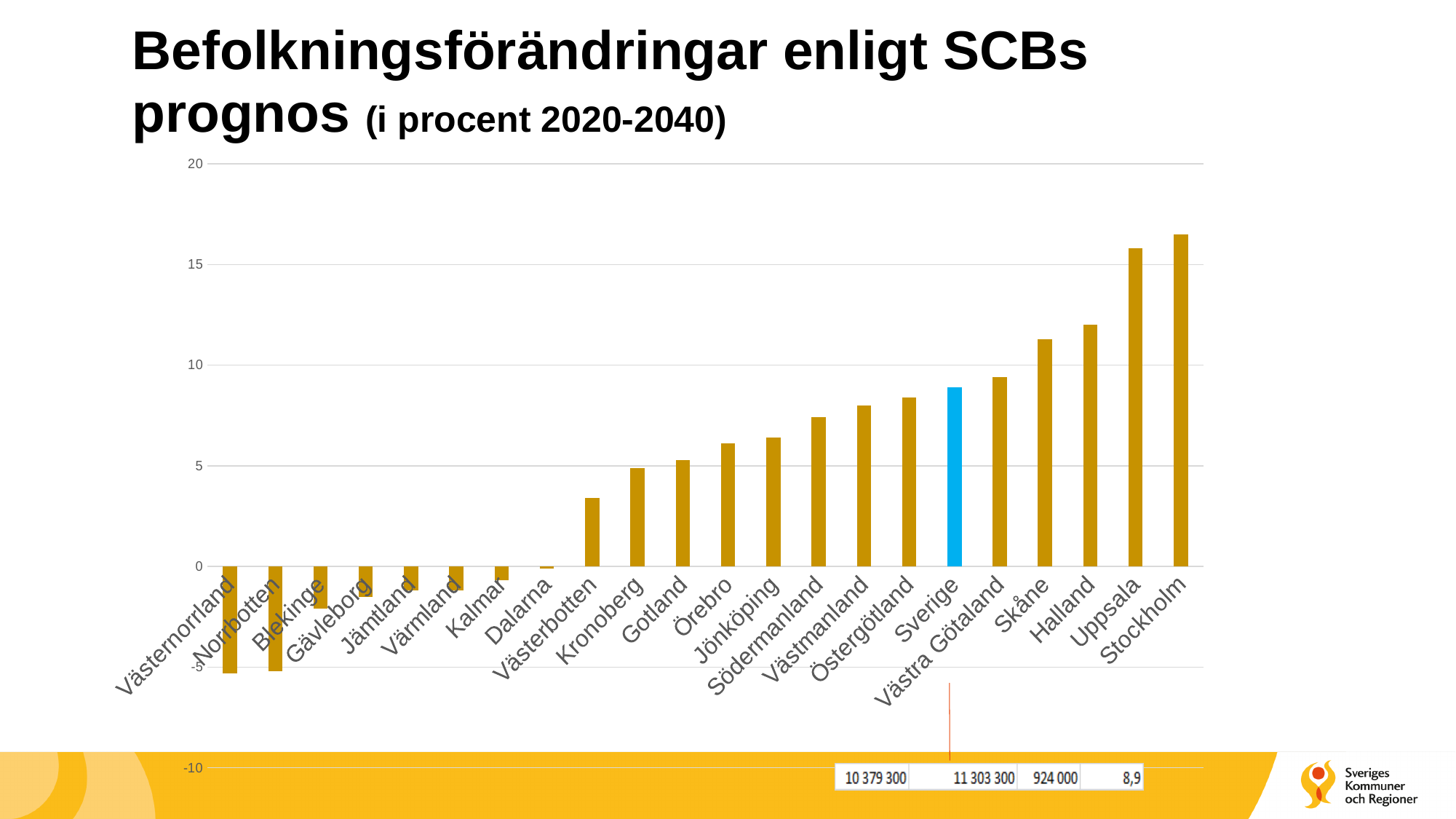
Is the value for Skåne greater or less than 10? greater Do the values generally rise or fall moving from left to right along the x axis? rise Which category has the highest value in the chart? Stockholm Which has the larger value, Örebro or Gotland? Örebro Is the value for Stockholm greater or less than 15? greater Is the value for Östergötland greater or less than 10? less Which category's bar is coloured blue instead of gold? Sverige Which has the larger value, Uppsala or Halland? Uppsala What kind of chart is shown on the slide? bar chart How many categories are plotted on the x axis of the chart? 22